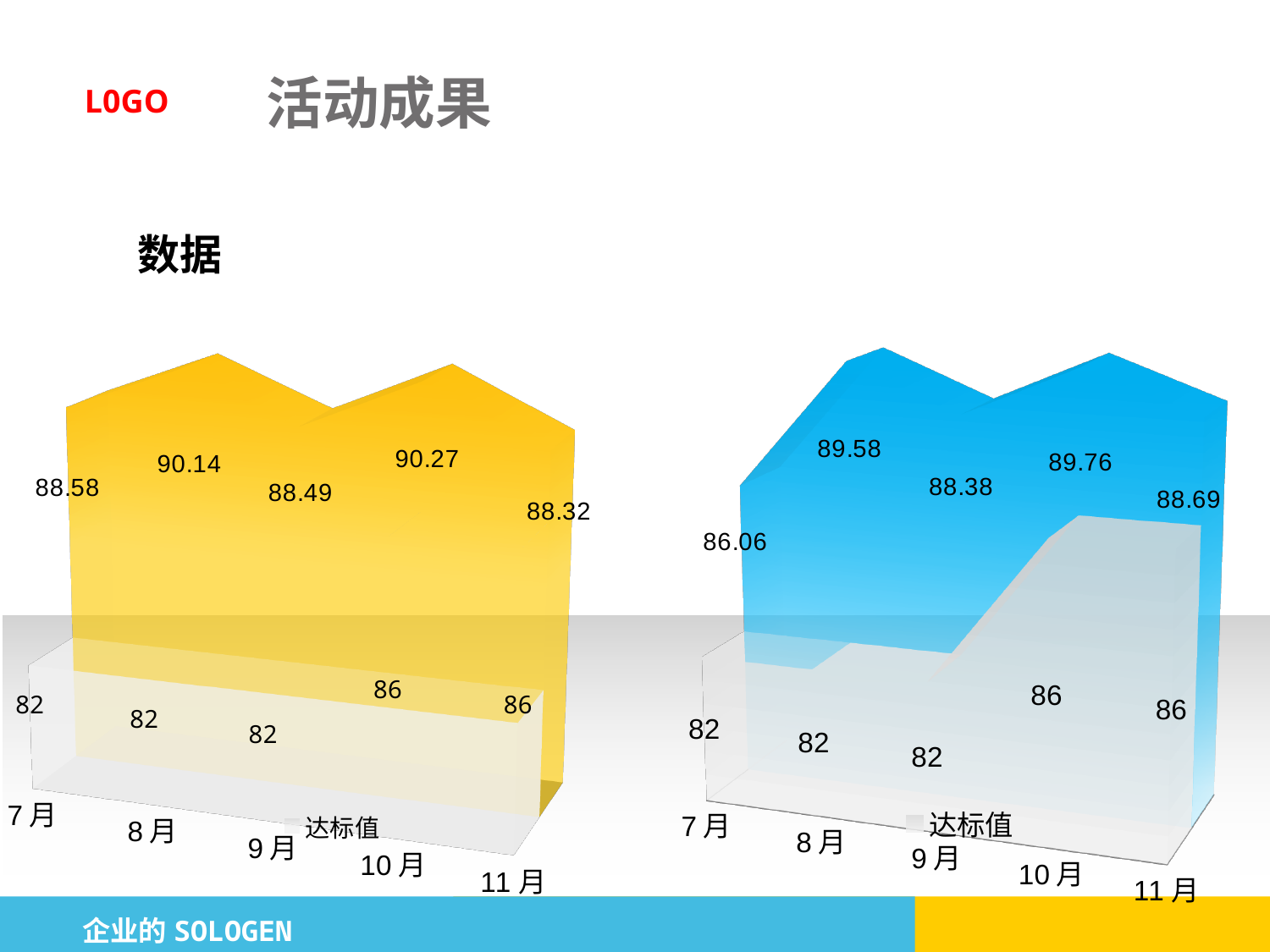
In the right (blue) chart, which month has the lowest value in the upper blue series? 7月 In the right (blue) chart, what is the difference between the upper series value for 11月 and the 达标值 for 11月? 2.69 In the left (yellow) chart, what is the difference between the upper series value and the 达标值 for 7月? 6.58 In the left (yellow) chart, which month has the lowest value in the upper yellow series? 11月 In the right (blue) chart, what is the value of the upper blue series for 7月? 86.06 In the left (yellow) chart, what is the 达标值 for 10月? 86 In the right (blue) chart, which month has the highest value in the upper blue series? 10月 In the left (yellow) chart, what is the value of the upper yellow series for 8月? 90.14 In the left (yellow) chart, which month has the highest value in the upper yellow series? 10月 What type of chart is the right (blue) chart? area chart How many months are shown on the x axis of the left (yellow) chart? 5 In the right (blue) chart, is the upper series value for 9月 larger or smaller than the value for 8月? smaller